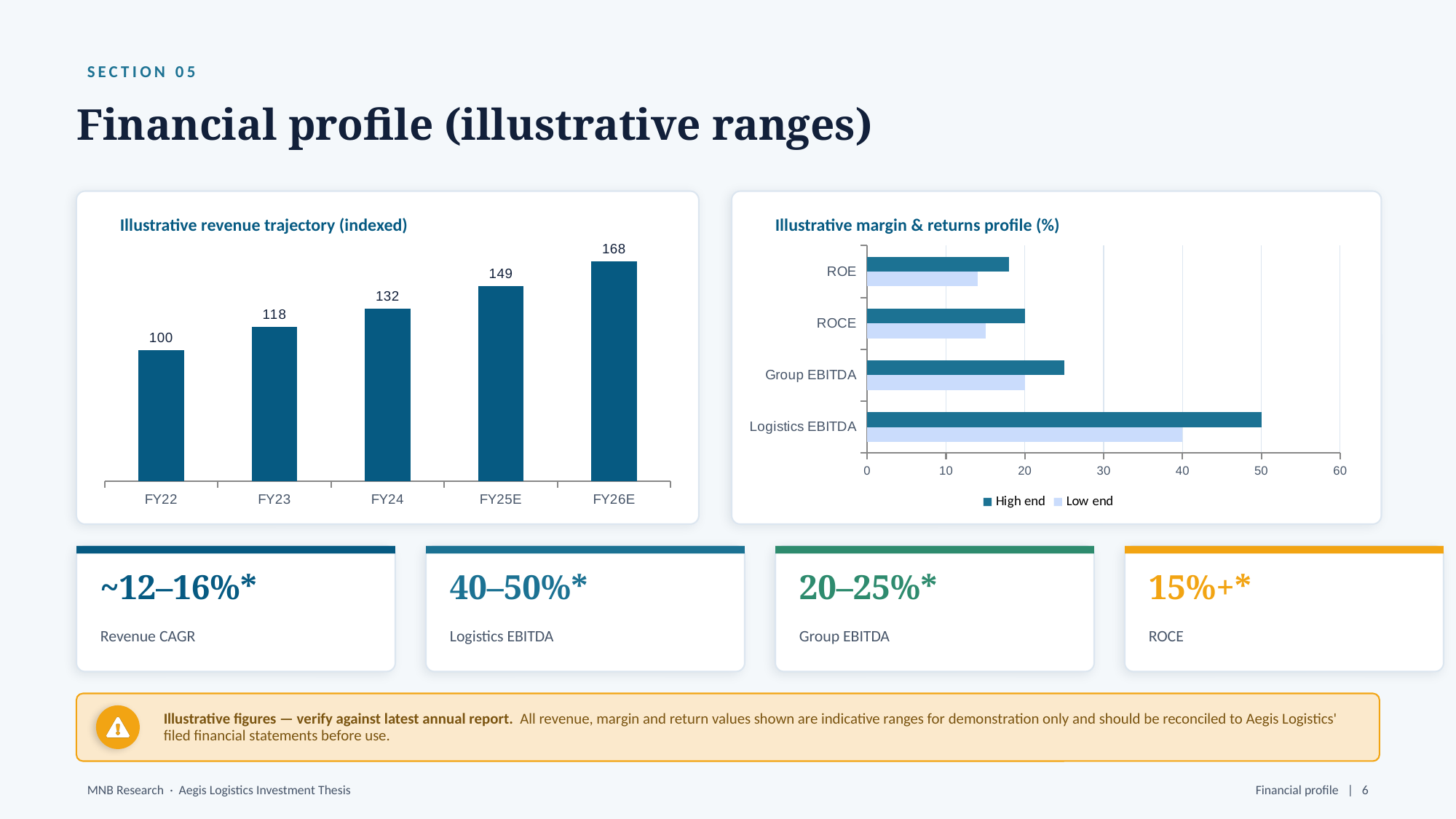
In the 'Illustrative revenue trajectory (indexed)' chart, do the values rise or fall from FY22 to FY26E? rise In the 'Illustrative margin & returns profile (%)' chart, which category has the highest High end value? Logistics EBITDA In the 'Illustrative margin & returns profile (%)' chart, which is larger: the High end value for Group EBITDA or the High end value for ROCE? Group EBITDA What kind of chart is the 'Illustrative revenue trajectory (indexed)' chart? bar chart In the 'Illustrative revenue trajectory (indexed)' chart, what is the value for FY26E? 168 In the 'Illustrative margin & returns profile (%)' chart, is the Low end value for ROE greater or less than 20? less In the 'Illustrative margin & returns profile (%)' chart, is the High end value for Logistics EBITDA greater or less than 40? greater In the 'Illustrative revenue trajectory (indexed)' chart, how many fiscal years are plotted? 5 In the 'Illustrative revenue trajectory (indexed)' chart, which fiscal year has the lowest value? FY22 In the 'Illustrative revenue trajectory (indexed)' chart, what is the value for FY24? 132 In the 'Illustrative revenue trajectory (indexed)' chart, what is the difference between the FY25E and FY23 values? 31 How many series does the legend of the 'Illustrative margin & returns profile (%)' chart list? 2